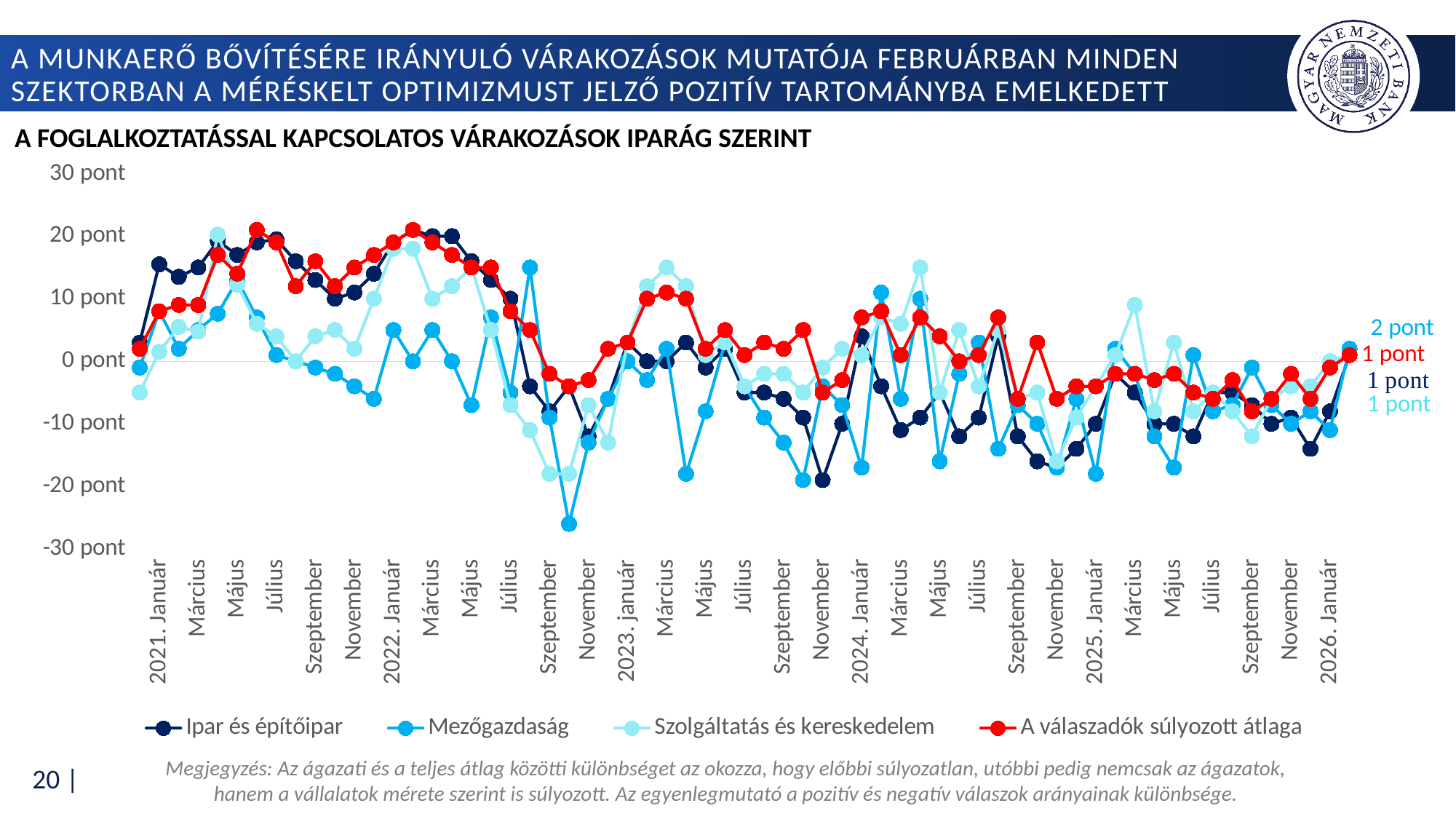
What is the first label on the x axis? 2021. Január What is the latest value labelled for A válaszadók súlyozott átlaga at the right end of the chart? 1 pont How many series does the legend list? 4 What is the difference between the latest labelled values of Mezőgazdaság and Szolgáltatás és kereskedelem? 1 pont Which series reaches the lowest point anywhere on the chart? Mezőgazdaság Is the value for Ipar és építőipar in 2022 Március greater or less than 10 pont? greater What colour is the line for A válaszadók súlyozott átlaga? red What is the latest value labelled for Ipar és építőipar at the right end of the chart? 1 pont What kind of chart is shown on the slide? line chart What is the latest value labelled for Mezőgazdaság at the right end of the chart? 2 pont What is the title of the chart? A FOGLALKOZTATÁSSAL KAPCSOLATOS VÁRAKOZÁSOK IPARÁG SZERINT Which series has the highest labelled value at the right end of the chart? Mezőgazdaság